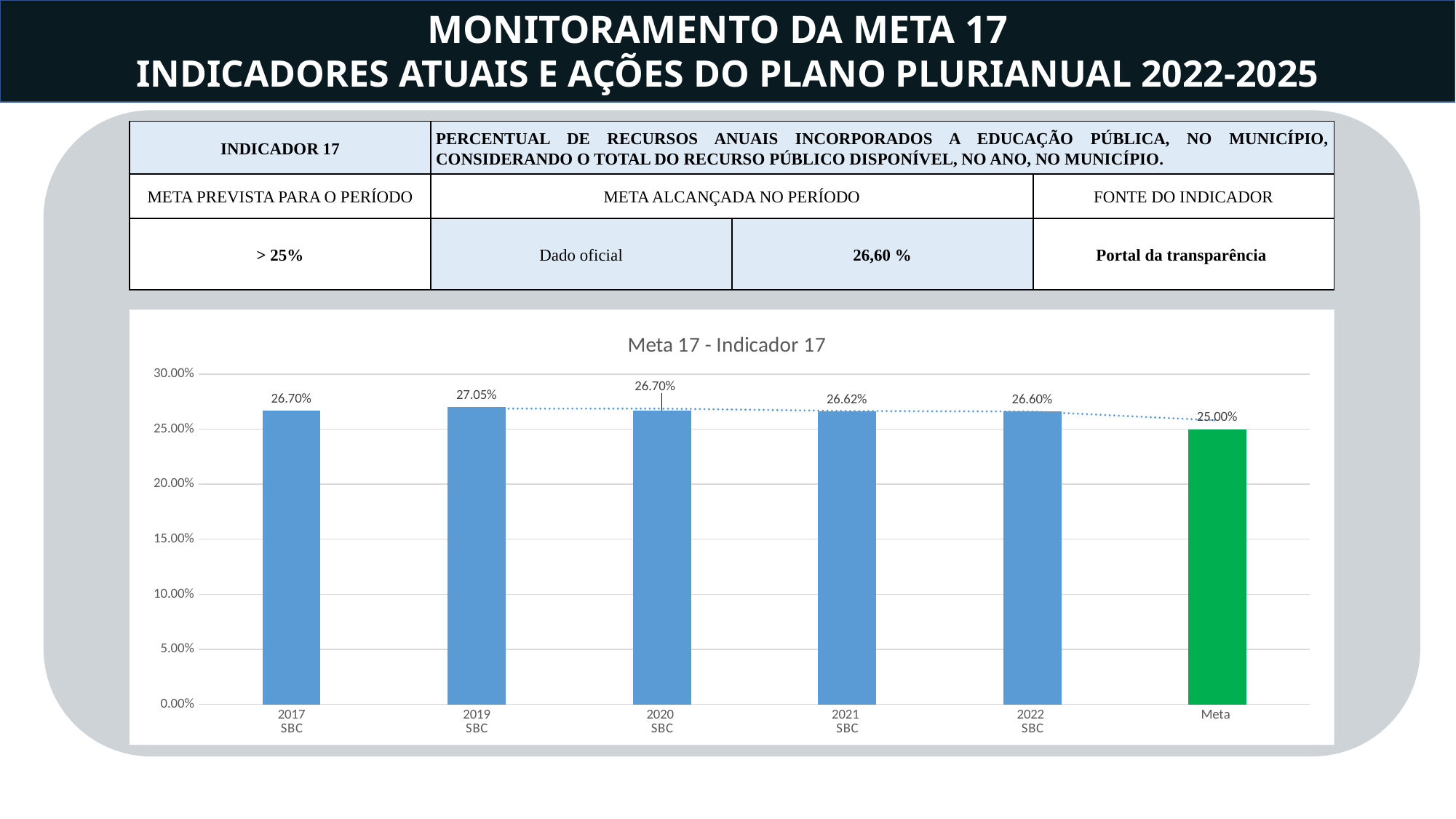
How many bars are plotted in the chart? 6 What is the value for 2019 SBC in the chart? 27.05% What is the value for 2021 SBC in the chart? 26.62% What is the difference between the 2017 SBC value and the 2022 SBC value? 0.10% Which is larger, the value for 2019 SBC or the value for 2022 SBC? 2019 SBC What kind of chart is shown on the slide? Bar chart What is the value of the Meta bar in the chart? 25.00% Which category has the lowest value in the chart? Meta What is the difference between the 2019 SBC value and the Meta value? 2.05% What is the value for 2022 SBC in the chart? 26.60% Which category has the highest value in the chart? 2019 SBC What is the title of the chart? Meta 17 - Indicador 17